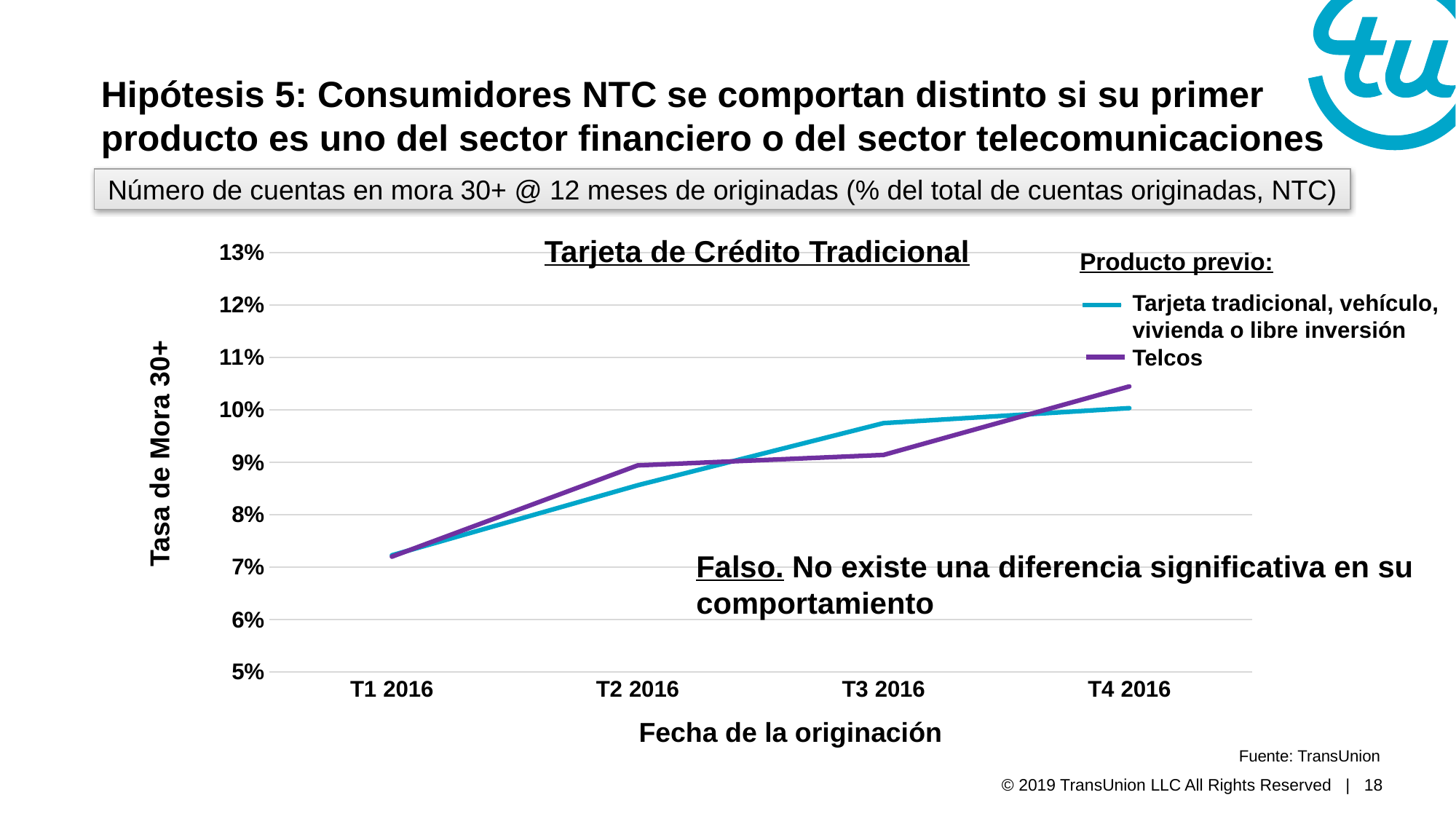
What is the label of the y axis? Tasa de Mora 30+ Is the value for Tarjeta tradicional, vehículo, vivienda o libre inversión at T1 2016 greater or less than 8%? less How many time points are plotted along the x axis? 4 Does the Telcos series rise or fall from T1 2016 to T4 2016? rise Is the value for Tarjeta tradicional, vehículo, vivienda o libre inversión at T3 2016 greater or less than 9%? greater At T3 2016, which series has the higher value: Telcos or Tarjeta tradicional, vehículo, vivienda o libre inversión? Tarjeta tradicional, vehículo, vivienda o libre inversión Is the value for Telcos at T4 2016 greater or less than 10%? greater How many series does the legend list? 2 What kind of chart is shown on the slide? line chart What is the title of the chart? Tarjeta de Crédito Tradicional At which origination date does the Telcos series reach its highest value? T4 2016 At T4 2016, which series has the higher value: Telcos or Tarjeta tradicional, vehículo, vivienda o libre inversión? Telcos